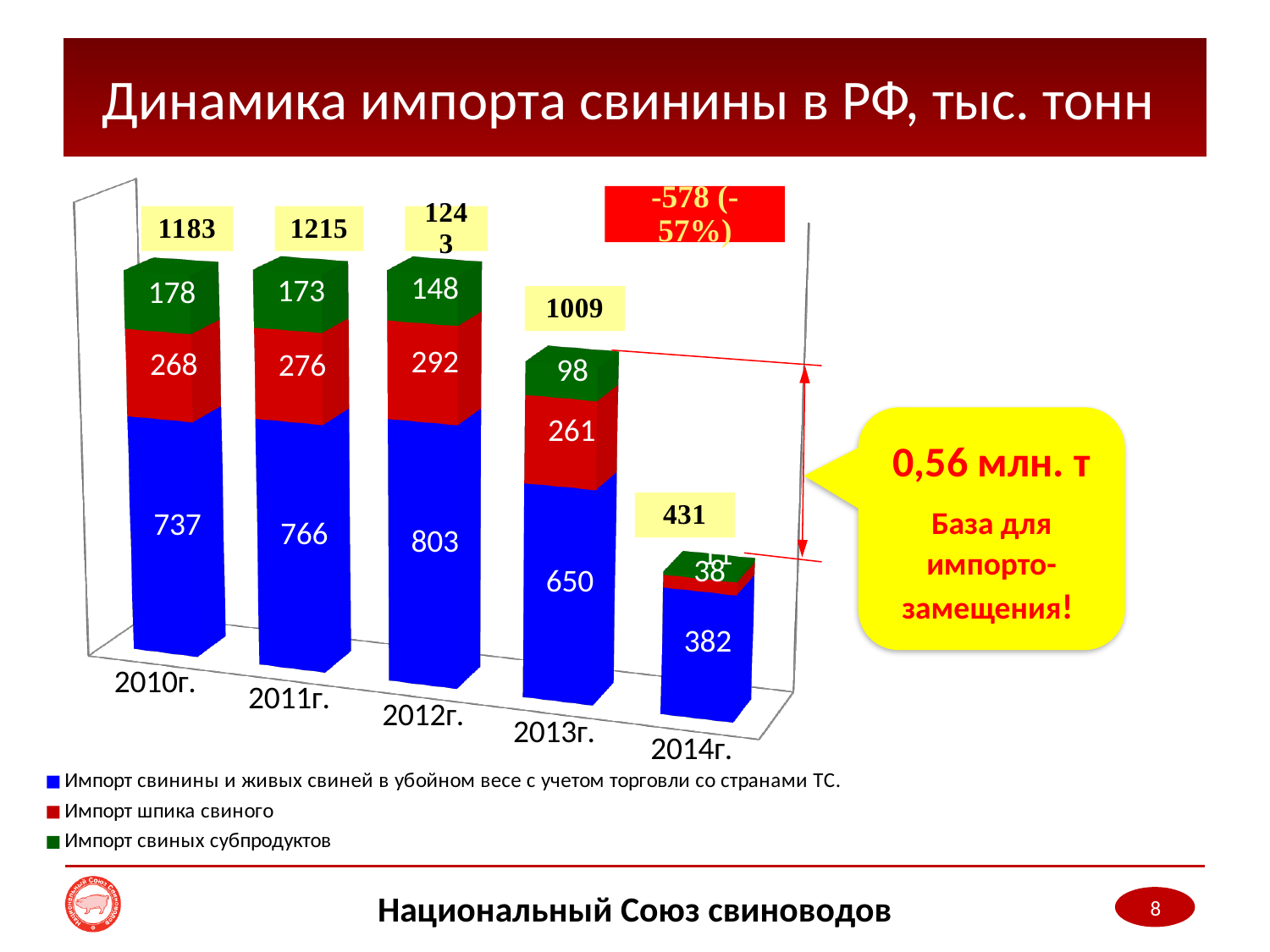
What is the title of the chart? Динамика импорта свинины в РФ, тыс. тонн What is the value of 'Импорт свиных субпродуктов' for 2010г.? 178 Which is larger: 'Импорт шпика свиного' in 2011г. or in 2012г.? 2012г. Which year has the lowest total import? 2014г. What is the total of the stacked bar for 2011г.? 1215 How many series does the legend list? 3 What is the difference between the totals for 2013г. and 2014г.? 578 Which year has the highest total import? 2012г. What type of chart is shown on the slide? stacked bar chart How many years (categories) are shown on the x axis? 5 What is the value of 'Импорт шпика свиного' for 2013г.? 261 What is the value of 'Импорт свинины и живых свиней в убойном весе с учетом торговли со странами ТС.' for 2012г.? 803